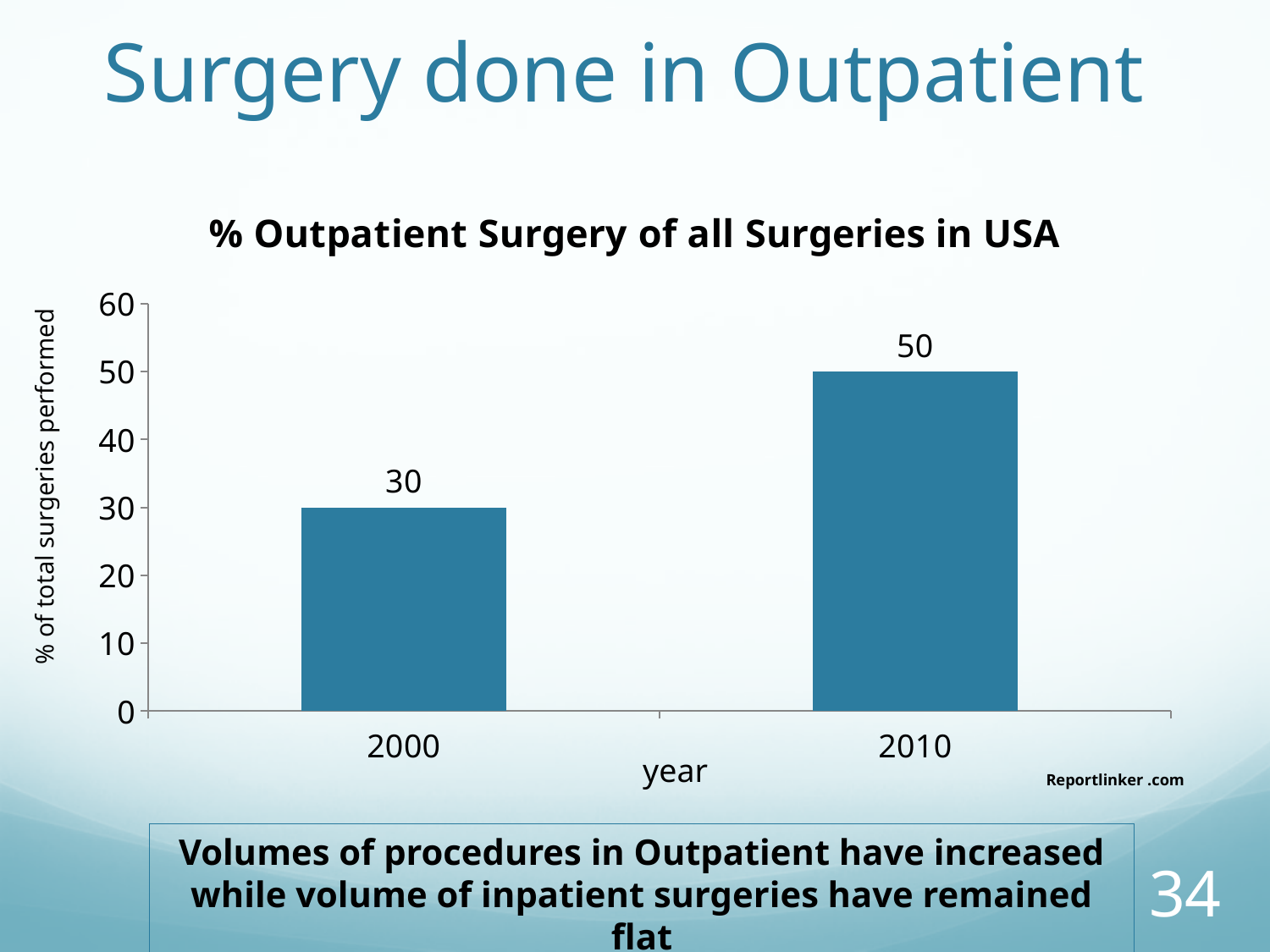
Which year has the lowest value? 2000 Which year has the highest value? 2010 Is the value for 2010 greater or less than 40? greater What is the value for 2000? 30 What is the title of the chart? % Outpatient Surgery of all Surgeries in USA Do the values rise or fall from 2000 to 2010? rise What is the difference between the values for 2010 and 2000? 20 What is the value for 2010? 50 How many years are shown on the x axis? 2 What kind of chart is shown? bar chart Which is larger, the value for 2000 or the value for 2010? 2010 What is the label of the y axis? % of total surgeries performed